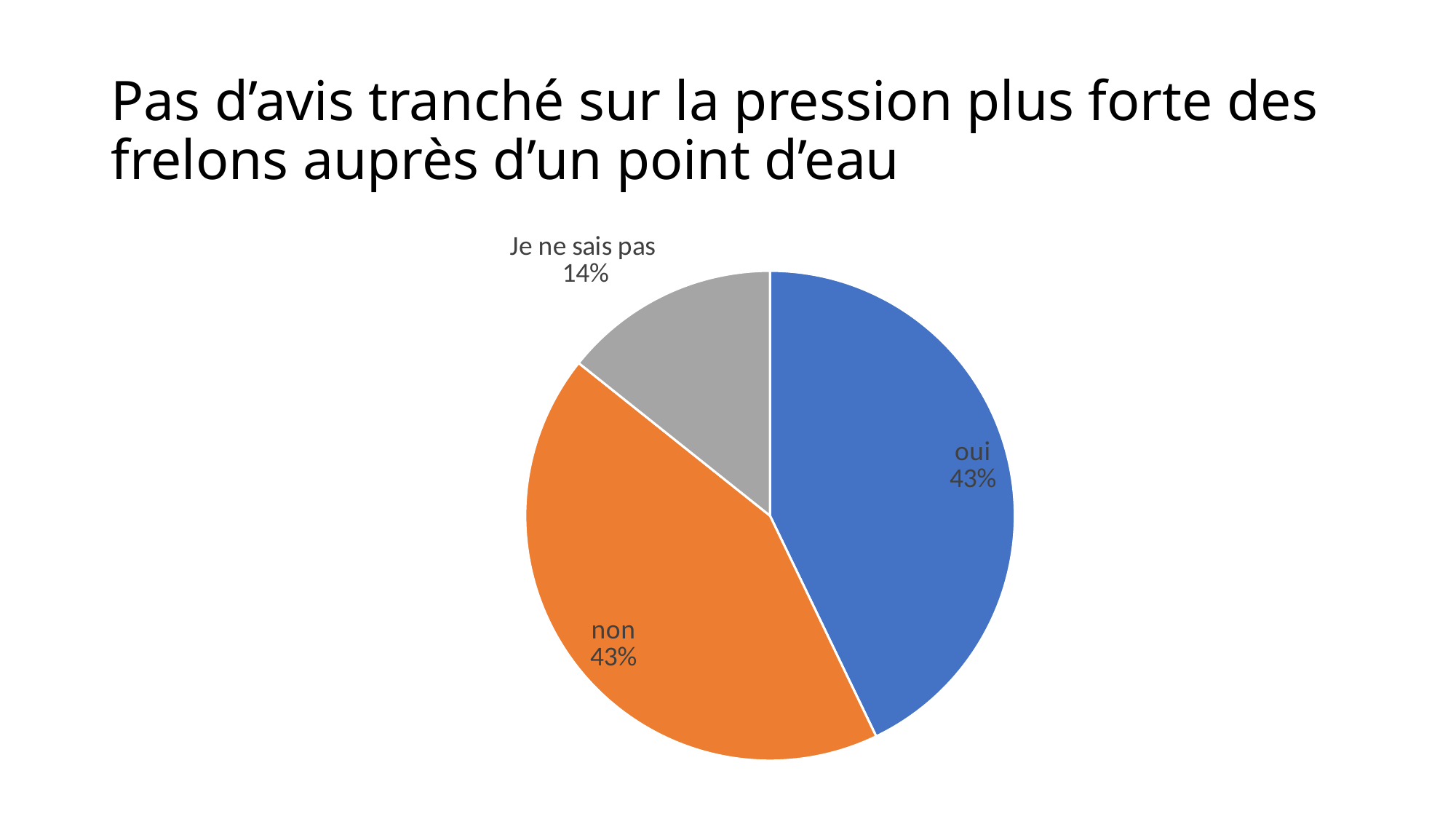
What kind of chart is shown on the slide? pie chart How many slices does the pie chart have? 3 Which is larger, the "non" slice or the "Je ne sais pas" slice? non What colour is the "oui" slice? blue Which slice of the pie is the smallest? Je ne sais pas What share of the pie does the "oui" slice represent? 43% What colour is the "Je ne sais pas" slice? grey What is the difference between the "oui" share and the "Je ne sais pas" share? 29% What share of the pie does the "non" slice represent? 43% What is the combined share of the "oui" and "non" slices? 86% What share of the pie does the "Je ne sais pas" slice represent? 14%